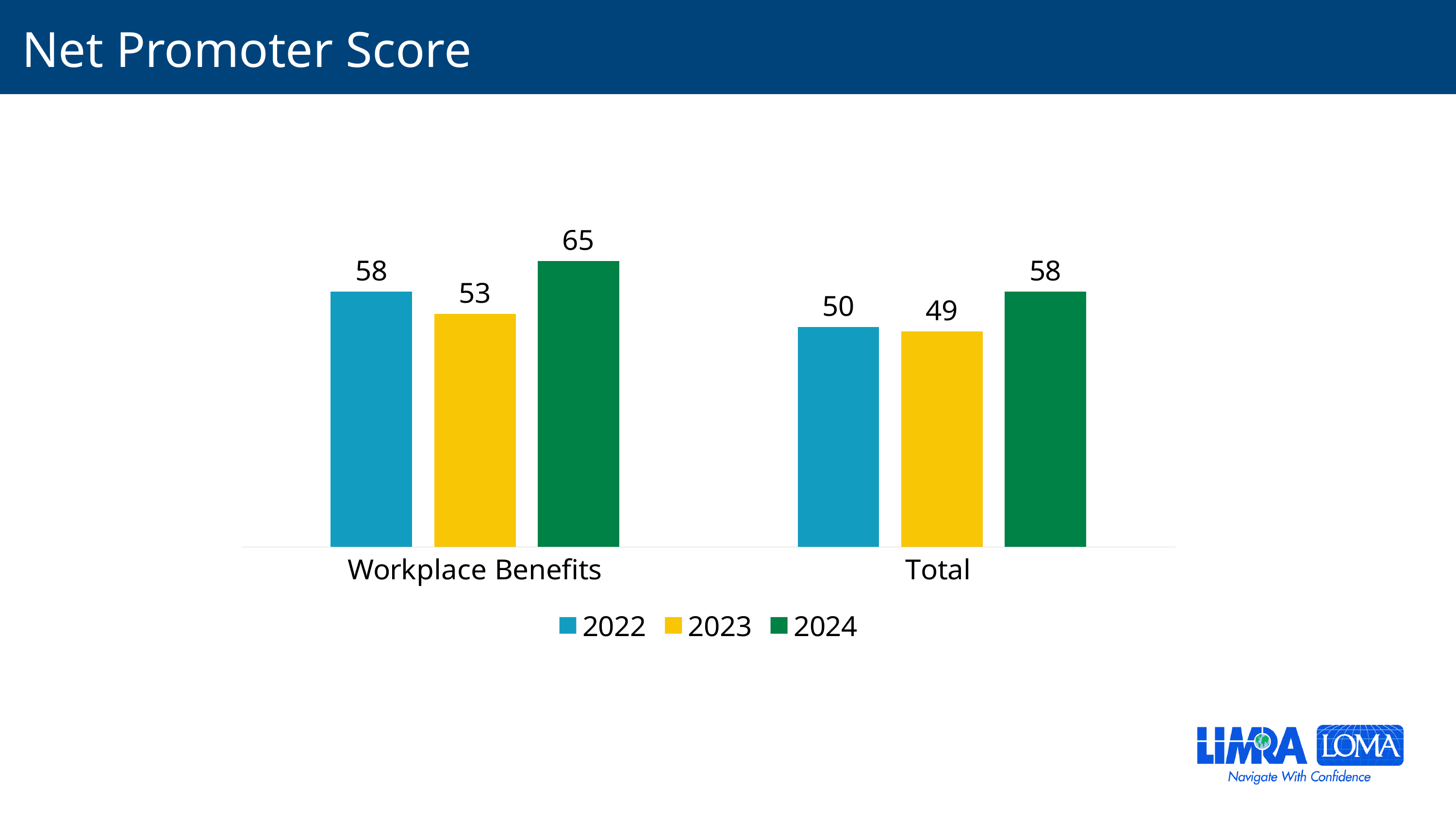
Which year has the highest Net Promoter Score for Workplace Benefits? 2024 Which is larger: the 2022 score for Workplace Benefits or the 2022 score for Total? Workplace Benefits What is the title of the chart? Net Promoter Score How many categories are shown on the x axis? 2 What is the Net Promoter Score for Total in 2023? 49 What is the difference between the 2024 and 2023 Net Promoter Scores for Workplace Benefits? 12 What is the Net Promoter Score for Workplace Benefits in 2024? 65 What kind of chart is shown on the slide? Bar chart Which year has the lowest Net Promoter Score for Total? 2023 How many series does the legend list? 3 What is the difference between the 2024 and 2022 Net Promoter Scores for Total? 8 What is the Net Promoter Score for Workplace Benefits in 2022? 58